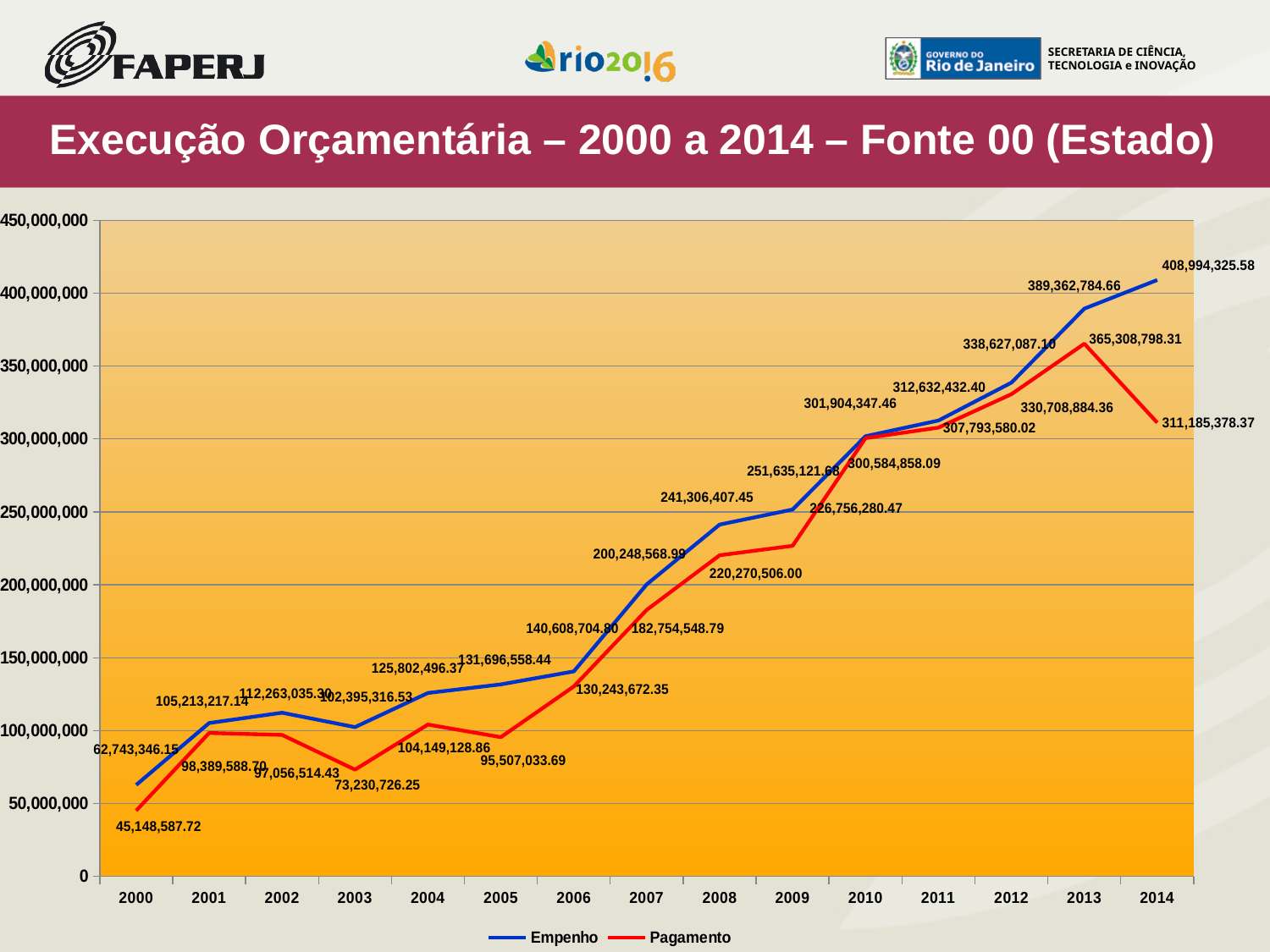
In which year is the Pagamento value highest? 2013 What is the Empenho value for 2014? 408,994,325.58 In which year is the Empenho value lowest? 2000 What is the Pagamento value for 2013? 365,308,798.31 What is the Pagamento value for 2000? 45,148,587.72 Is the Pagamento value for 2008 greater or less than 200,000,000? greater What is the Empenho value for 2007? 200,248,568.99 What is the difference between Empenho and Pagamento in 2014? 97,808,947.21 What kind of chart is shown on the slide? Line chart How many years are plotted on the x axis? 15 Which is larger in 2003, Empenho or Pagamento? Empenho How many series does the legend list? 2